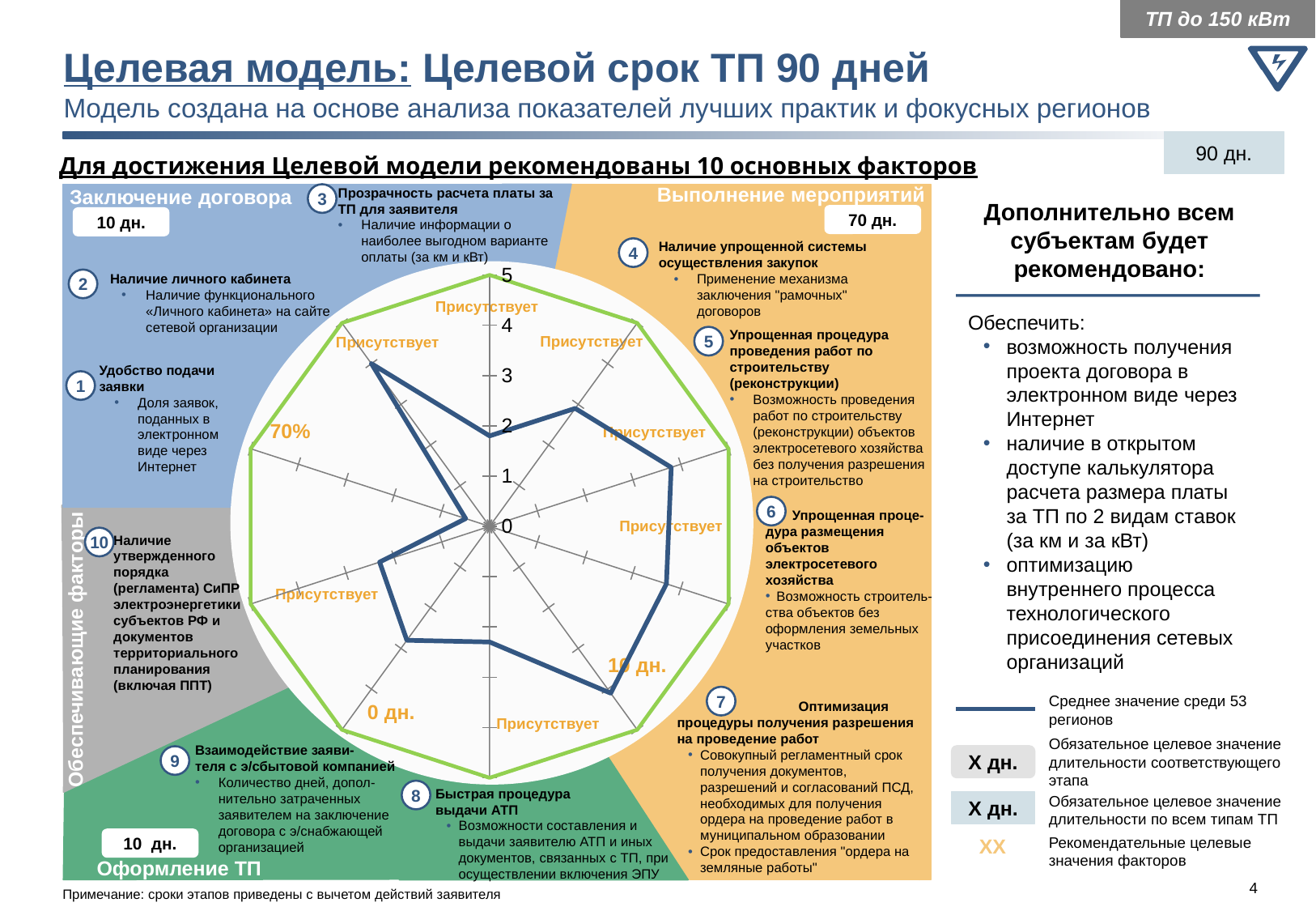
What is the highest value marked on the radar chart's scale? 5 Is the dark blue line's value on the upper-left axis (factor 2, "Присутствует") greater or less than 3? greater What kind of chart is shown on the slide? radar chart Is the dark blue line's value on the right axis (factor 5, "Присутствует") greater or less than 3? greater Is the dark blue line's value on the left axis labelled "70%" greater or less than 1? less According to the legend, what does the dark blue line on the radar chart represent? Среднее значение среди 53 регионов How many axes (factors) does the radar chart have? 10 On the radar chart, which line is larger on the left axis labelled "70%": the dark blue line or the green line? green line